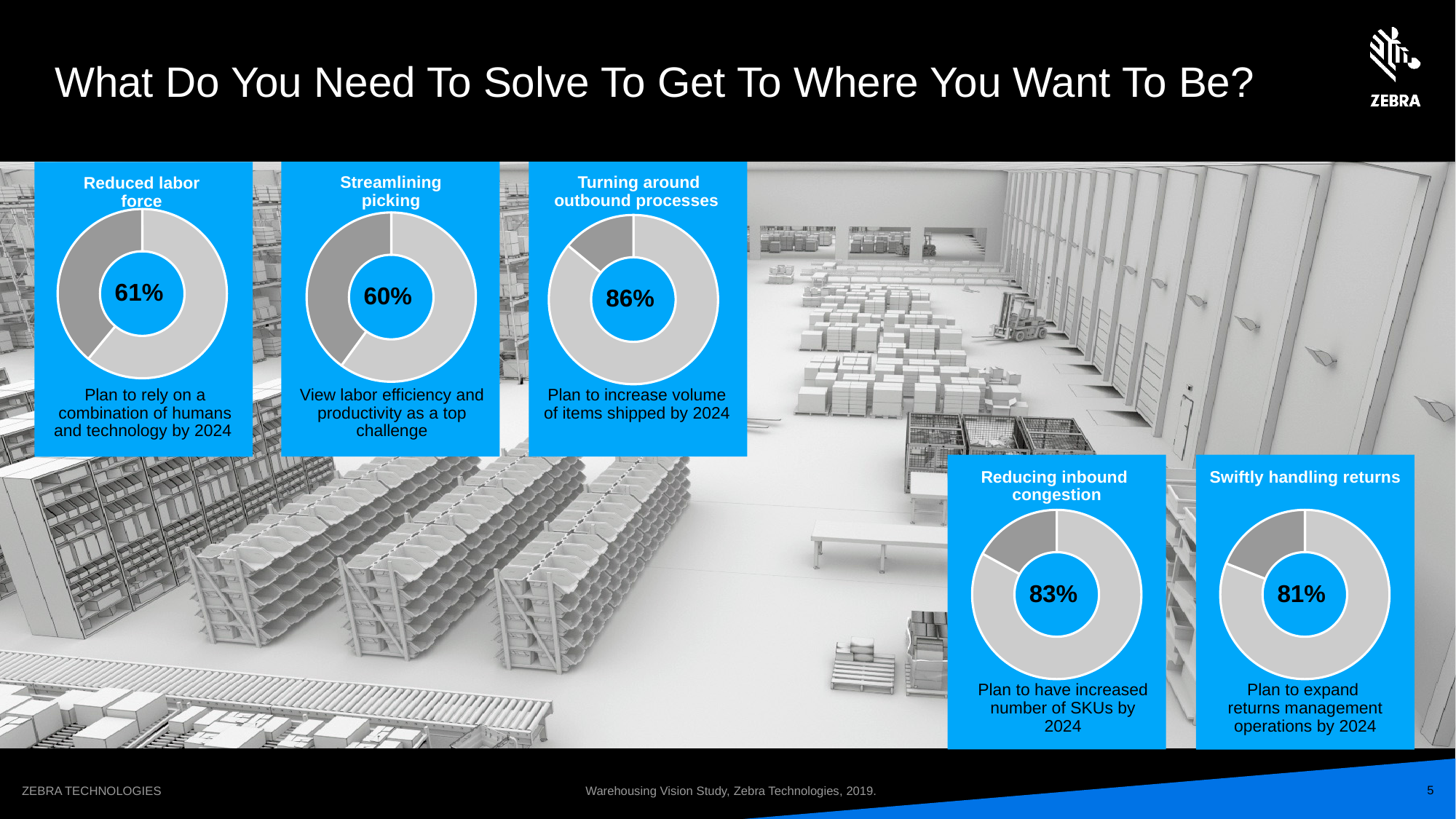
Across the five donut charts on the slide, which one shows the lowest percentage? Streamlining picking In the 'Swiftly handling returns' chart, what percentage plan to expand returns management operations by 2024? 81% What kind of chart is used in the 'Reduced labor force' panel? Donut chart What is the difference between the percentage in the 'Turning around outbound processes' chart and the percentage in the 'Swiftly handling returns' chart? 5% In the 'Streamlining picking' chart, what percentage is shown? 60% Which shows a larger percentage: the 'Reducing inbound congestion' chart or the 'Reduced labor force' chart? Reducing inbound congestion In the 'Turning around outbound processes' chart, what percentage plan to increase volume of items shipped by 2024? 86% What is the title of the chart that shows 60%? Streamlining picking In the 'Reduced labor force' chart, what percentage is shown in the centre of the donut? 61% Across the five donut charts on the slide, which one shows the highest percentage? Turning around outbound processes How many donut charts are shown on the slide? 5 In the 'Reducing inbound congestion' chart, what percentage plan to have increased number of SKUs by 2024? 83%